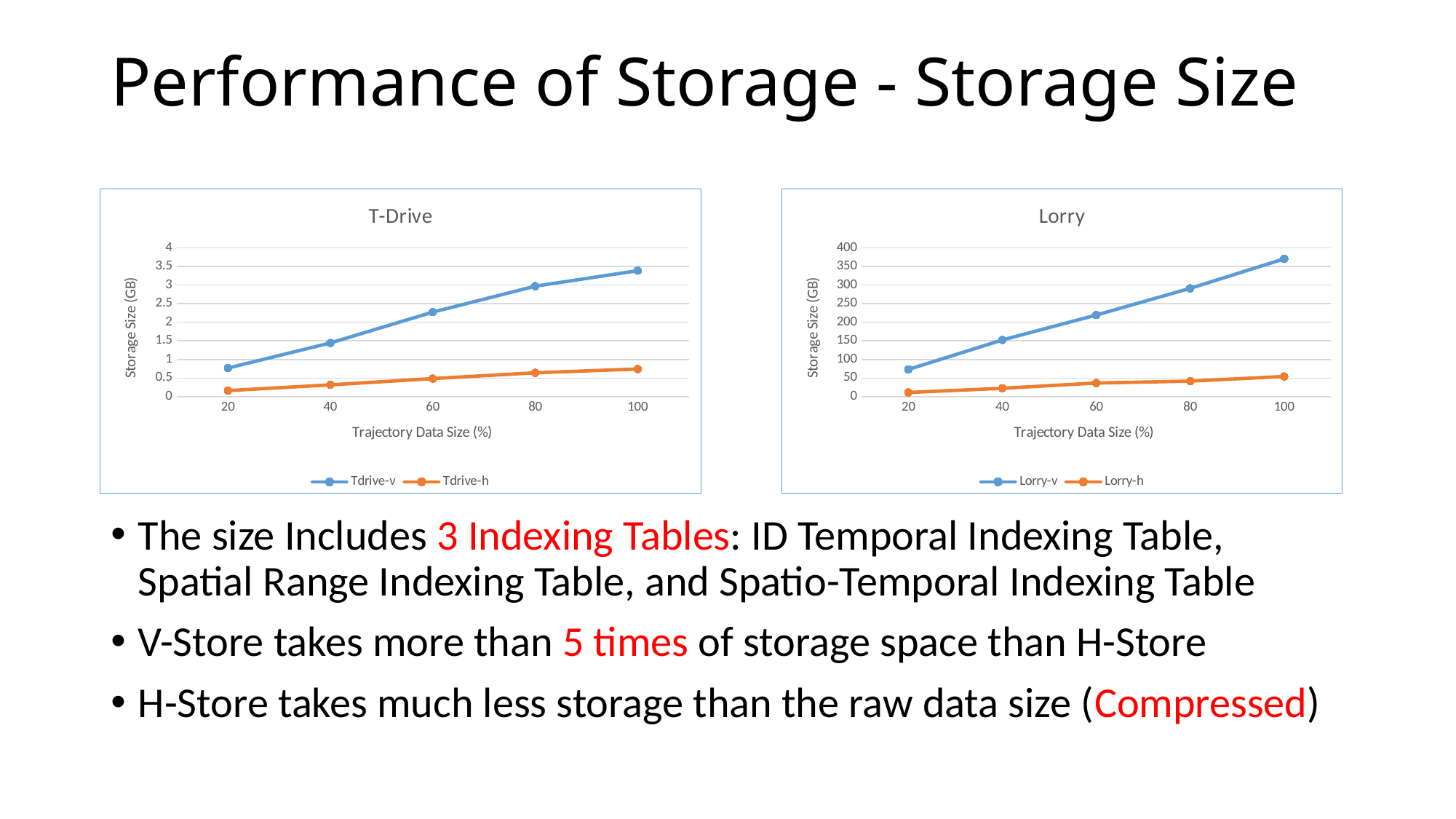
In the T-Drive chart, is the value for Tdrive-v at 20% trajectory data size greater or less than 1? less In the T-Drive chart, is the value for Tdrive-h at 100% trajectory data size greater or less than 1? less How many series does the legend of the Lorry chart list? 2 In the T-Drive chart, is the value for Tdrive-v at 100% trajectory data size greater or less than 3? greater In the Lorry chart, which series has the larger value at 80% trajectory data size, Lorry-v or Lorry-h? Lorry-v What type of chart is the T-Drive chart? line chart In the Lorry chart, at which trajectory data size is the Lorry-v value highest? 100 In the T-Drive chart, does the Tdrive-v series rise or fall as trajectory data size increases? rise How many data points are plotted for the Tdrive-v series in the T-Drive chart? 5 What is the y-axis label of the Lorry chart? Storage Size (GB)